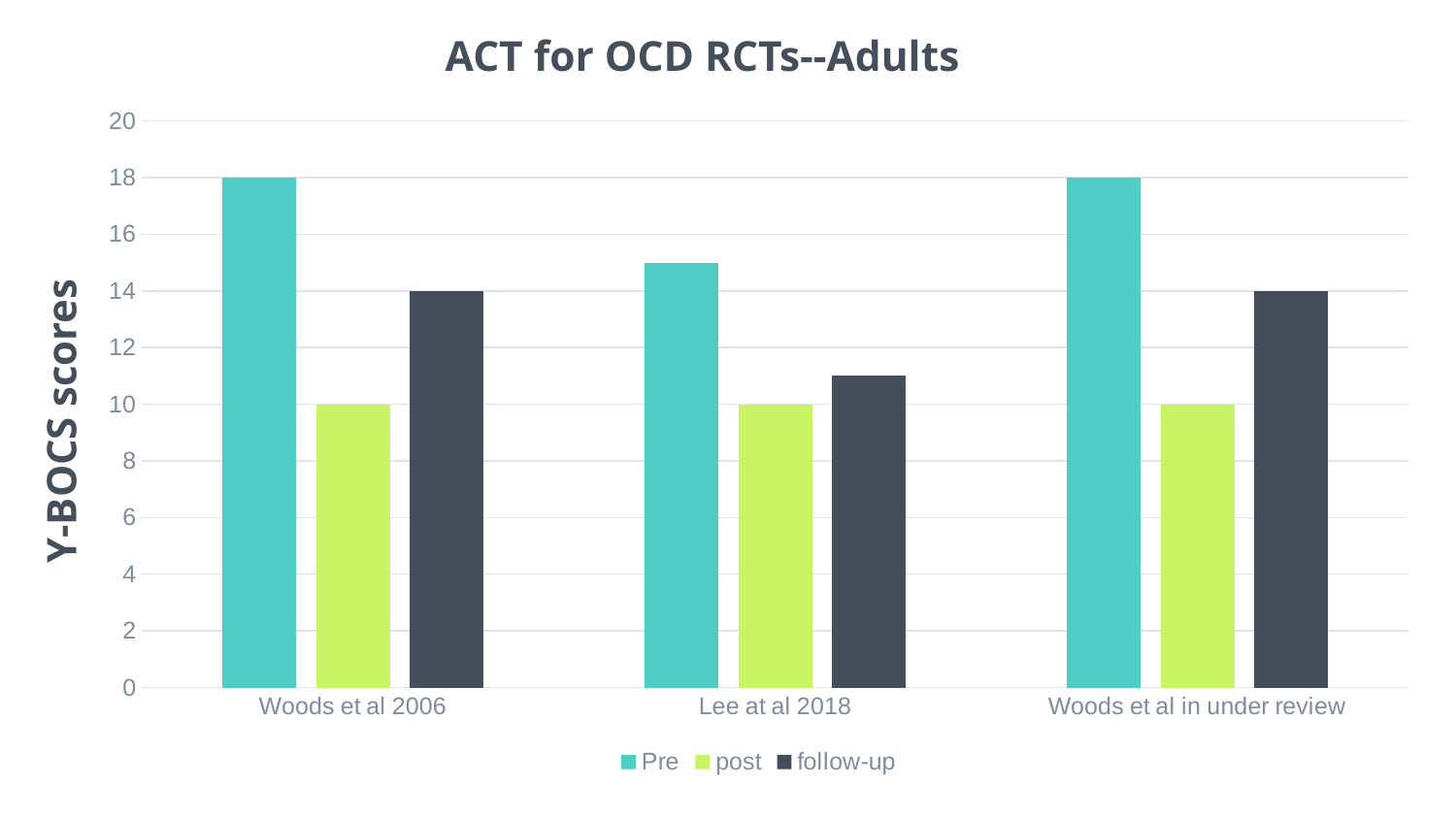
What is the difference between the Pre and post scores for Woods et al 2006? 8 Is the Pre value for Lee at al 2018 greater or less than 14? greater What is the title of the chart? ACT for OCD RCTs--Adults What is the post Y-BOCS score for Lee at al 2018? 10 What is the follow-up Y-BOCS score for Woods et al in under review? 14 What type of chart is shown on the slide? bar chart How many series does the legend list? 3 How many studies (categories) are shown on the x axis? 3 Is the follow-up value for Lee at al 2018 greater or less than 12? less What is the Pre Y-BOCS score for Woods et al 2006? 18 For Woods et al 2006, which is larger, the post score or the follow-up score? follow-up Which study has the lowest Pre score? Lee at al 2018